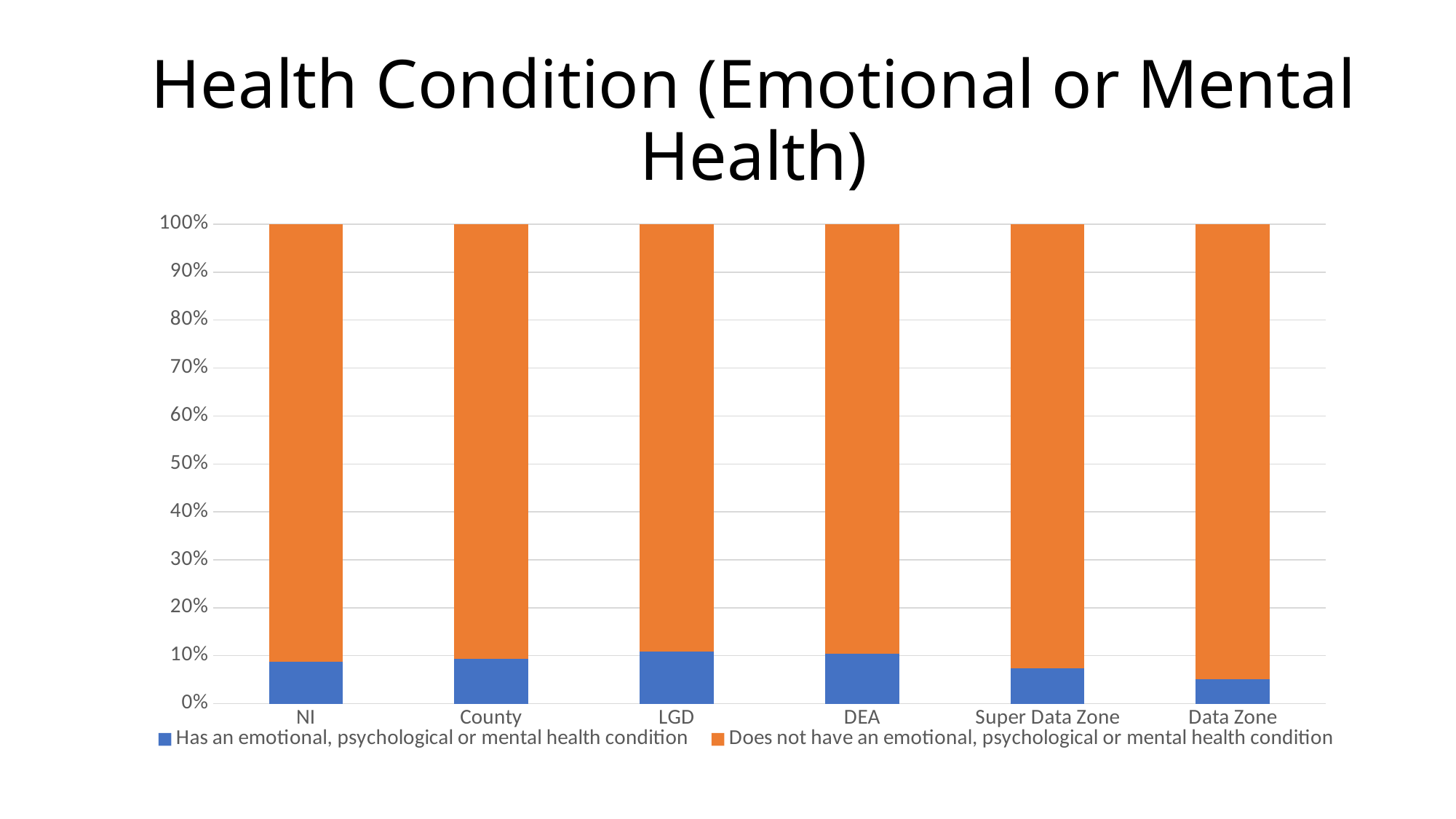
Is the value for 'Has an emotional, psychological or mental health condition' for Data Zone greater or less than 10%? less What kind of chart is shown on the slide? Stacked bar chart Which category has the lowest share for 'Has an emotional, psychological or mental health condition'? Data Zone How many categories are shown along the x axis? 6 What is the total height of each stacked bar? 100% Which colour represents 'Does not have an emotional, psychological or mental health condition'? Orange Is the value for 'Does not have an emotional, psychological or mental health condition' for Super Data Zone greater or less than 90%? greater What is the title of the chart? Health Condition (Emotional or Mental Health) Which is larger: the 'Has an emotional, psychological or mental health condition' share for LGD or for Data Zone? LGD How many series does the legend list? 2 Which is larger: the 'Has an emotional, psychological or mental health condition' share for NI or for Data Zone? NI